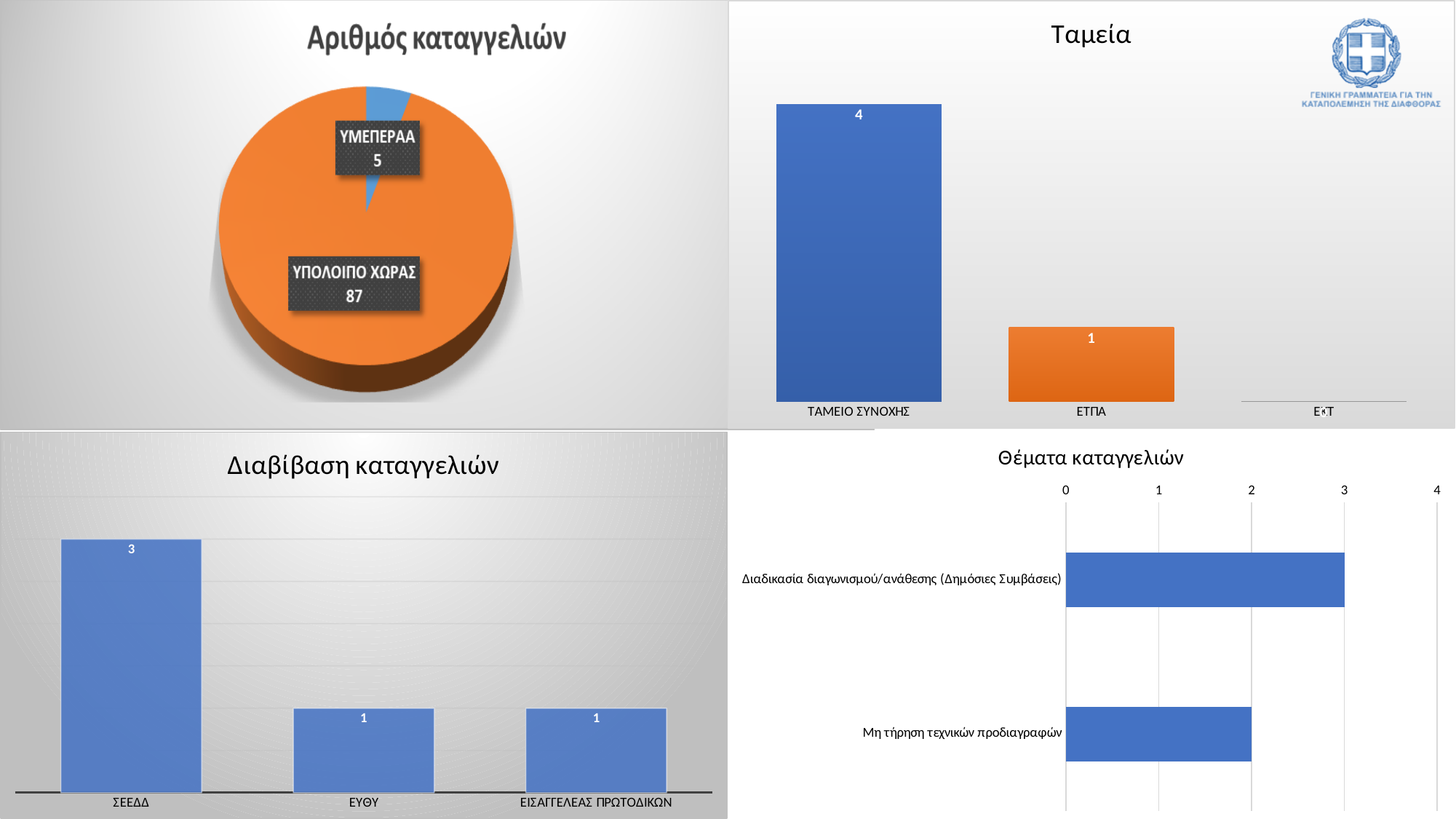
In the pie chart 'Αριθμός καταγγελιών', what is the value for ΥΠΟΛΟΙΠΟ ΧΩΡΑΣ? 87 In the chart 'Ταμεία', what is the value for ΤΑΜΕΙΟ ΣΥΝΟΧΗΣ? 4 In the chart 'Θέματα καταγγελιών', what is the value for 'Μη τήρηση τεχνικών προδιαγραφών'? 2 In the chart 'Ταμεία', what is the difference between ΤΑΜΕΙΟ ΣΥΝΟΧΗΣ and ΕΤΠΑ? 3 In the chart 'Διαβίβαση καταγγελιών', which is larger, ΣΕΕΔΔ or ΕΥΘΥ? ΣΕΕΔΔ In the pie chart 'Αριθμός καταγγελιών', what is the value for ΥΜΕΠΕΡΑΑ? 5 What kind of chart is 'Θέματα καταγγελιών'? Bar chart In the chart 'Διαβίβαση καταγγελιών', what is the value for ΣΕΕΔΔ? 3 In the pie chart 'Αριθμός καταγγελιών', what is the difference between ΥΠΟΛΟΙΠΟ ΧΩΡΑΣ and ΥΜΕΠΕΡΑΑ? 82 In the chart 'Ταμεία', which category has the highest value? ΤΑΜΕΙΟ ΣΥΝΟΧΗΣ What kind of chart is 'Αριθμός καταγγελιών'? Pie chart In the chart 'Διαβίβαση καταγγελιών', how many categories are shown? 3